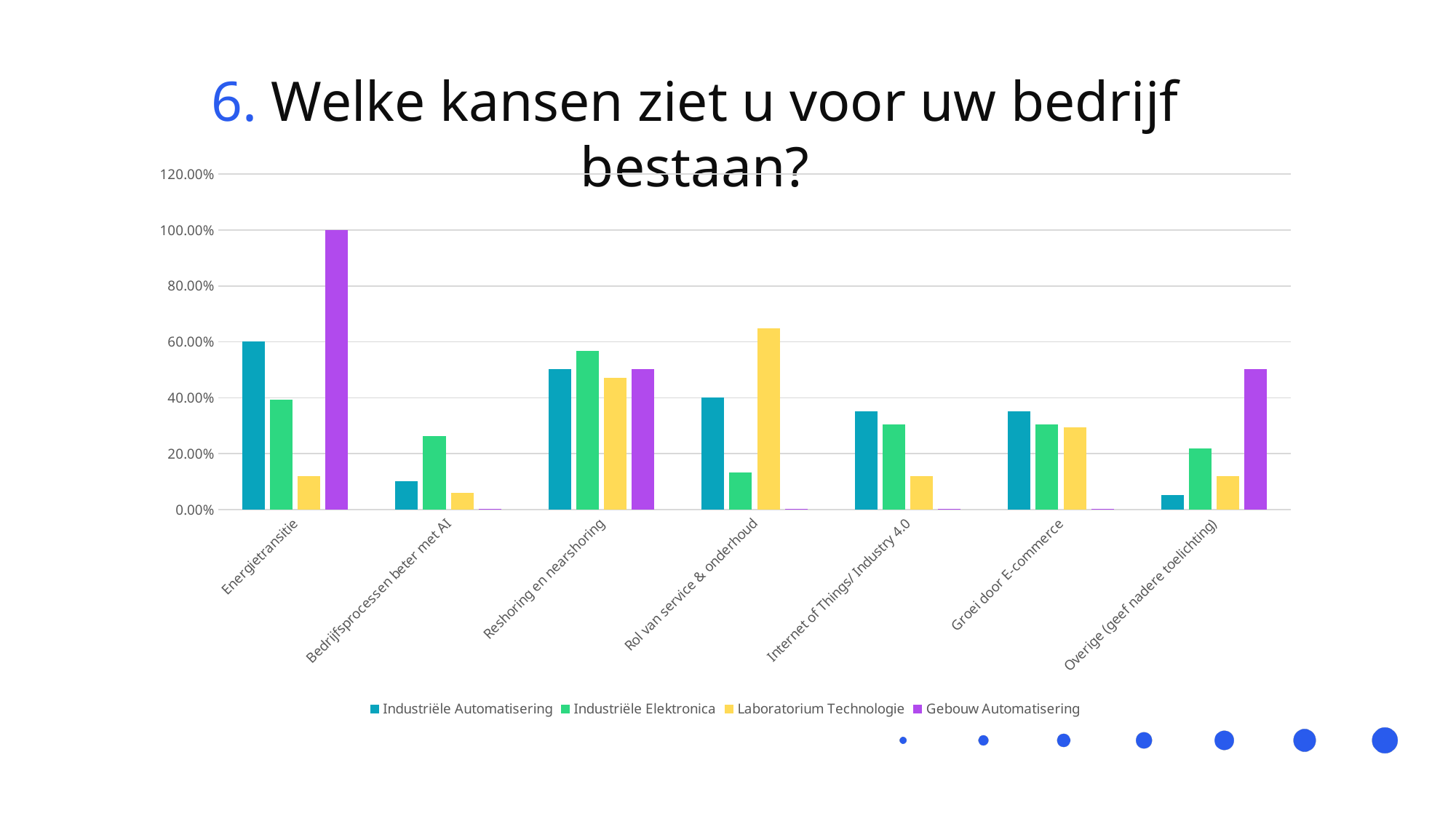
Is the value for Laboratorium Technologie in Rol van service & onderhoud greater or less than 60%? greater Is the value for Industriële Elektronica in Bedrijfsprocessen beter met AI greater or less than 40%? less What is the value for Gebouw Automatisering in the Energietransitie category? 100.00% Which category has the lowest value for Industriële Automatisering? Overige (geef nadere toelichting) In the Reshoring en nearshoring category, which is larger: Industriële Elektronica or Laboratorium Technologie? Industriële Elektronica How many categories are shown on the x axis? 7 Which category has the highest value for Laboratorium Technologie? Rol van service & onderhoud What kind of chart is shown on the slide? bar chart How many series does the legend list? 4 Which series is shown in purple in the legend? Gebouw Automatisering Which category has the highest value for Gebouw Automatisering? Energietransitie What is the value for Industriële Automatisering in the Energietransitie category? 60.00%